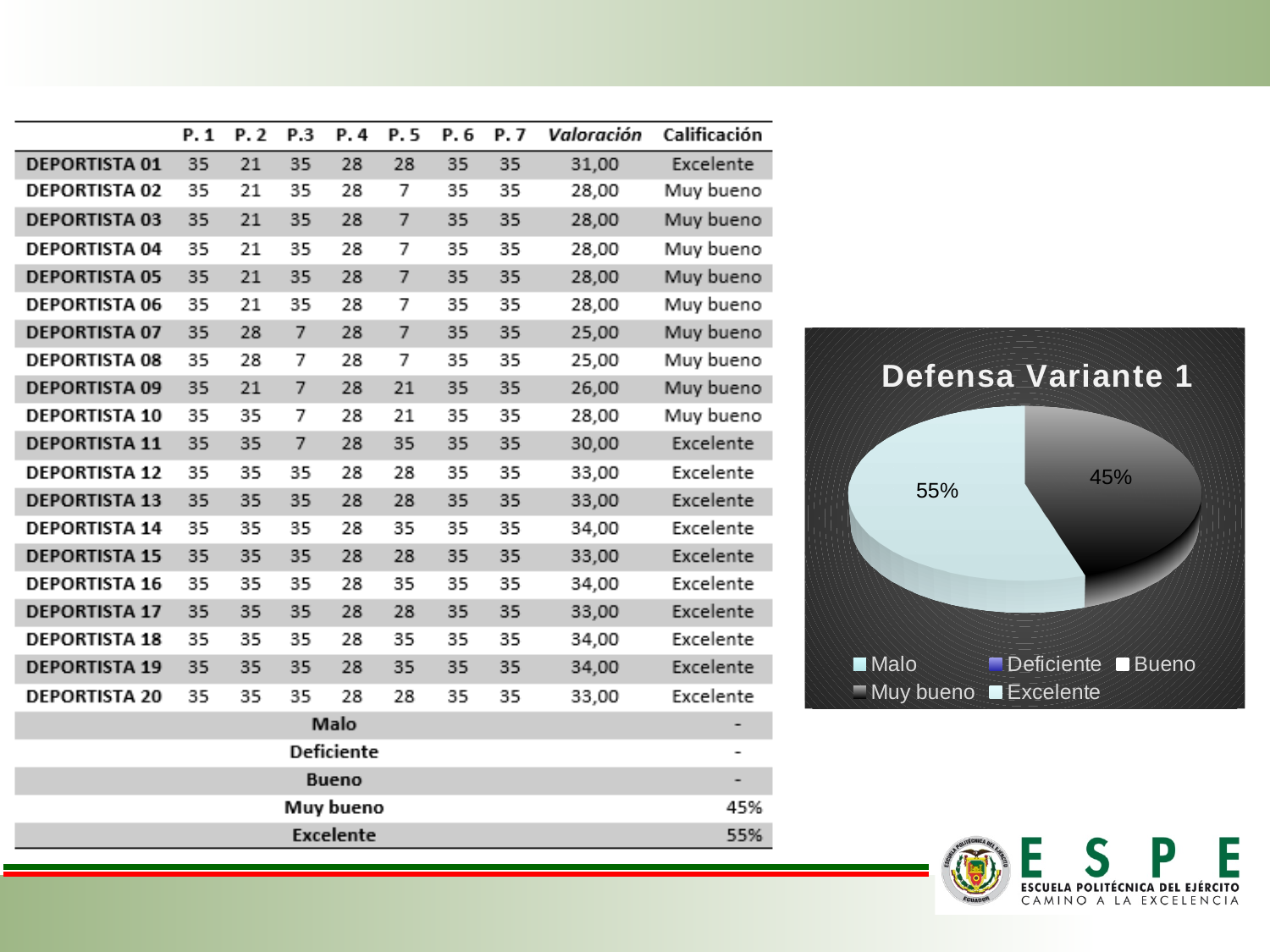
Is the share for Muy bueno greater or less than 50%? less Which slice is larger in the pie chart, Muy bueno or Excelente? Excelente What do the two labelled slices of the pie chart add up to? 100% How many entries does the legend of the pie chart list? 5 What share of the pie chart does the light blue slice (Excelente) represent? 55% What is the title of the pie chart? Defensa Variante 1 What is the difference in percentage points between the Excelente slice and the Muy bueno slice? 10 percentage points Which categories are listed in the legend of the pie chart? Malo, Deficiente, Bueno, Muy bueno, Excelente How many slices with a data label are visible in the pie chart? 2 Which category has the largest slice in the pie chart? Excelente What share of the pie chart does the dark gray slice (Muy bueno) represent? 45% What kind of chart is shown on the slide? Pie chart